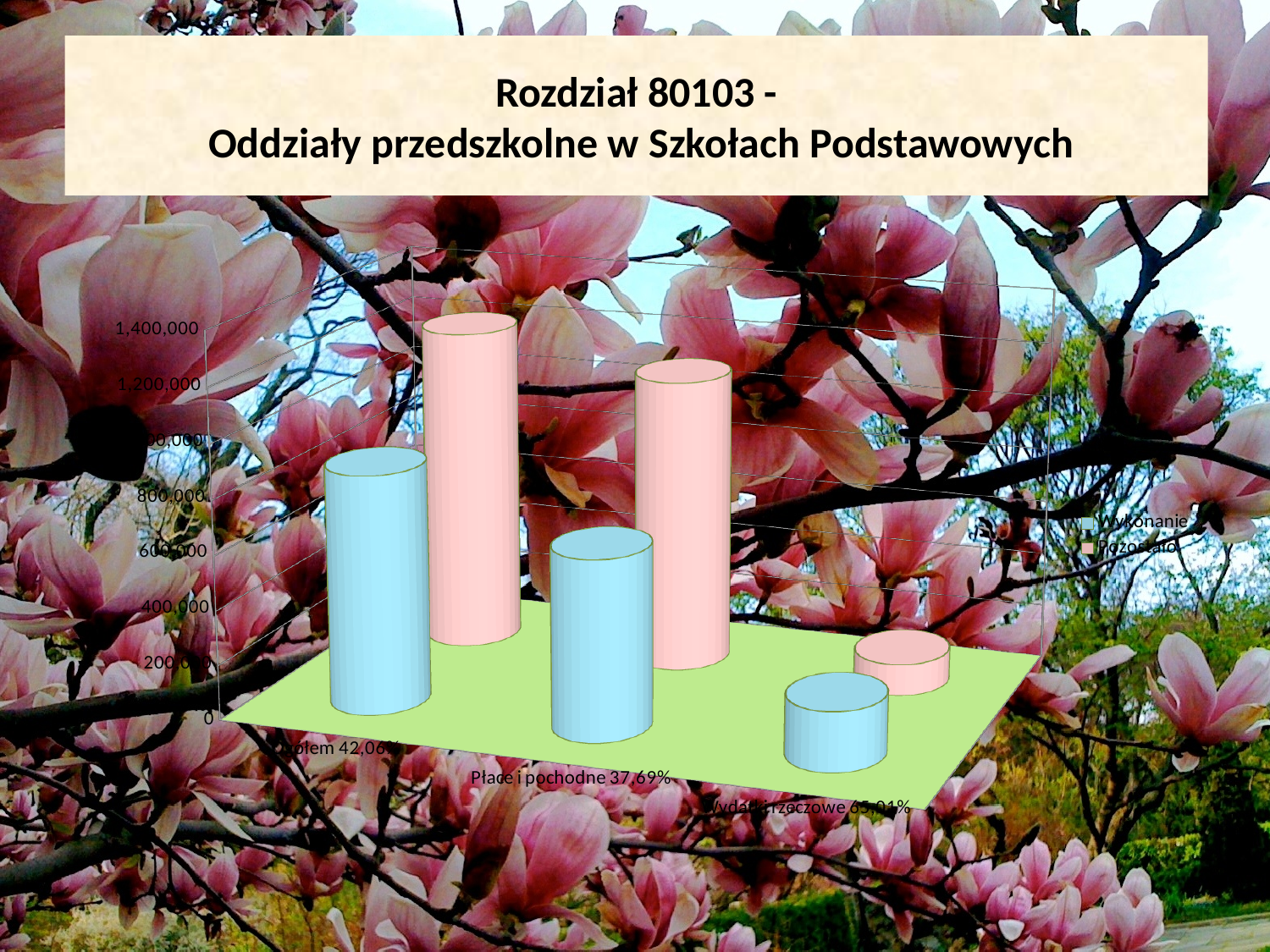
What is the title of the slide containing the chart? Rozdział 80103 - Oddziały przedszkolne w Szkołach Podstawowych What kind of chart is shown on the slide? bar chart For Ogółem 42,06%, which is larger: Wykonanie or Pozostało? Pozostało Is the Pozostało value for Ogółem 42,06% greater or less than 1,000,000? greater How many categories are shown on the x axis? 3 Which category has the highest Wykonanie value? Ogółem 42,06% How many series does the legend list? 2 What are the two series named in the legend? Wykonanie and Pozostało Is the Wykonanie value for Wydatki rzeczowe 65,01% greater or less than 400,000? less Which category has the highest Pozostało value? Ogółem 42,06% Is the Wykonanie value for Płace i pochodne 37,69% greater or less than 800,000? less Which category has the lowest Wykonanie value? Wydatki rzeczowe 65,01%